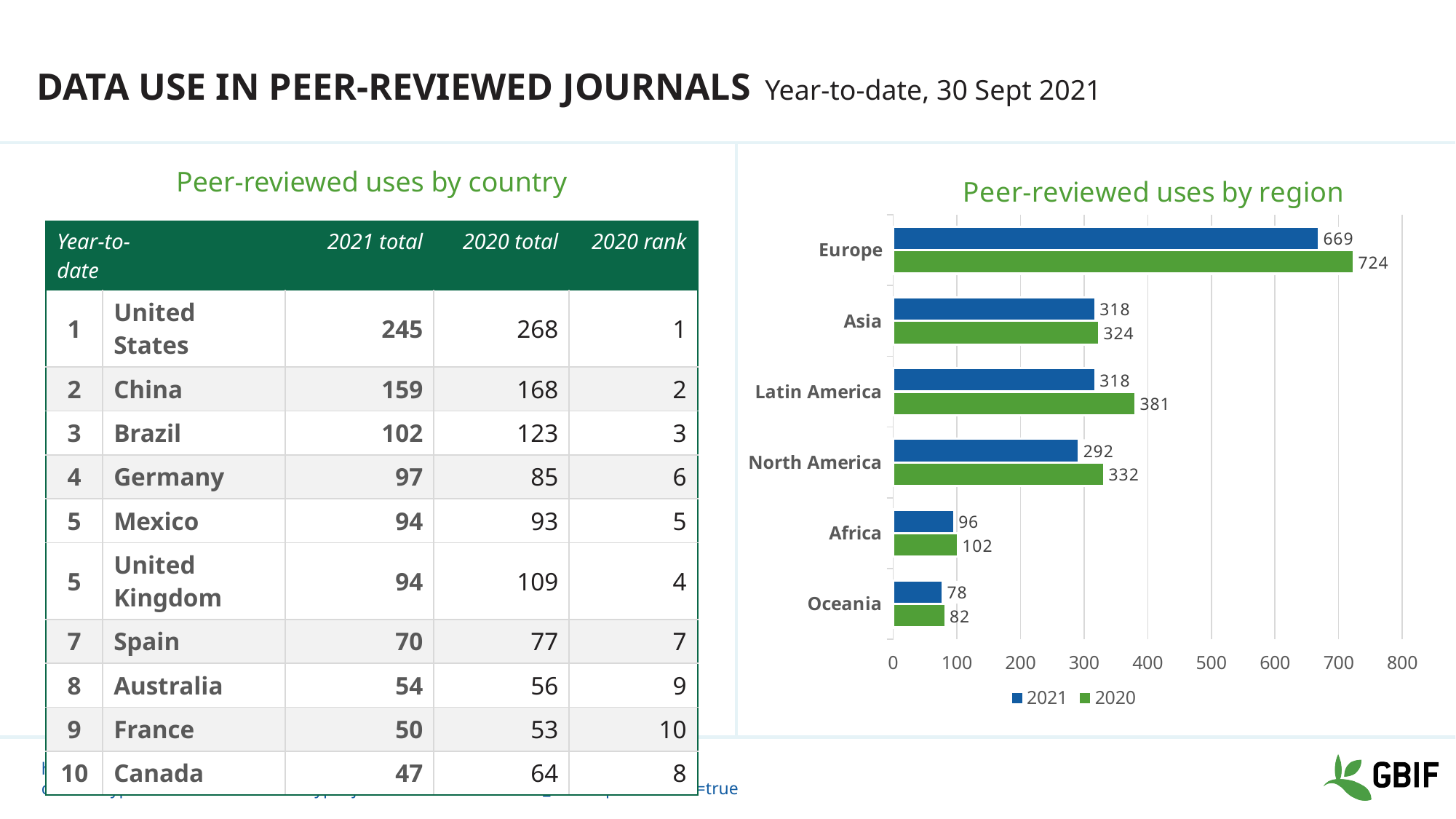
What kind of chart is 'Peer-reviewed uses by region'? Bar chart In the 'Peer-reviewed uses by region' chart, which region has the highest 2020 value? Europe In the 'Peer-reviewed uses by region' chart, what is the difference between the 2020 and 2021 values for North America? 40 In the 'Peer-reviewed uses by region' chart, what is the difference between the 2020 and 2021 values for Europe? 55 How many series does the legend of the 'Peer-reviewed uses by region' chart list? 2 In the 'Peer-reviewed uses by region' chart, which region has the lowest 2021 value? Oceania In the 'Peer-reviewed uses by region' chart, what is the 2020 value for Latin America? 381 In the 'Peer-reviewed uses by region' chart, is the 2021 value for North America greater or less than 300? less In the 'Peer-reviewed uses by region' chart, what is the 2020 value for Africa? 102 How many regions are shown in the 'Peer-reviewed uses by region' chart? 6 In the 'Peer-reviewed uses by region' chart, what is the 2021 value for Europe? 669 In the 'Peer-reviewed uses by region' chart, which is larger for Latin America: the 2021 value or the 2020 value? 2020